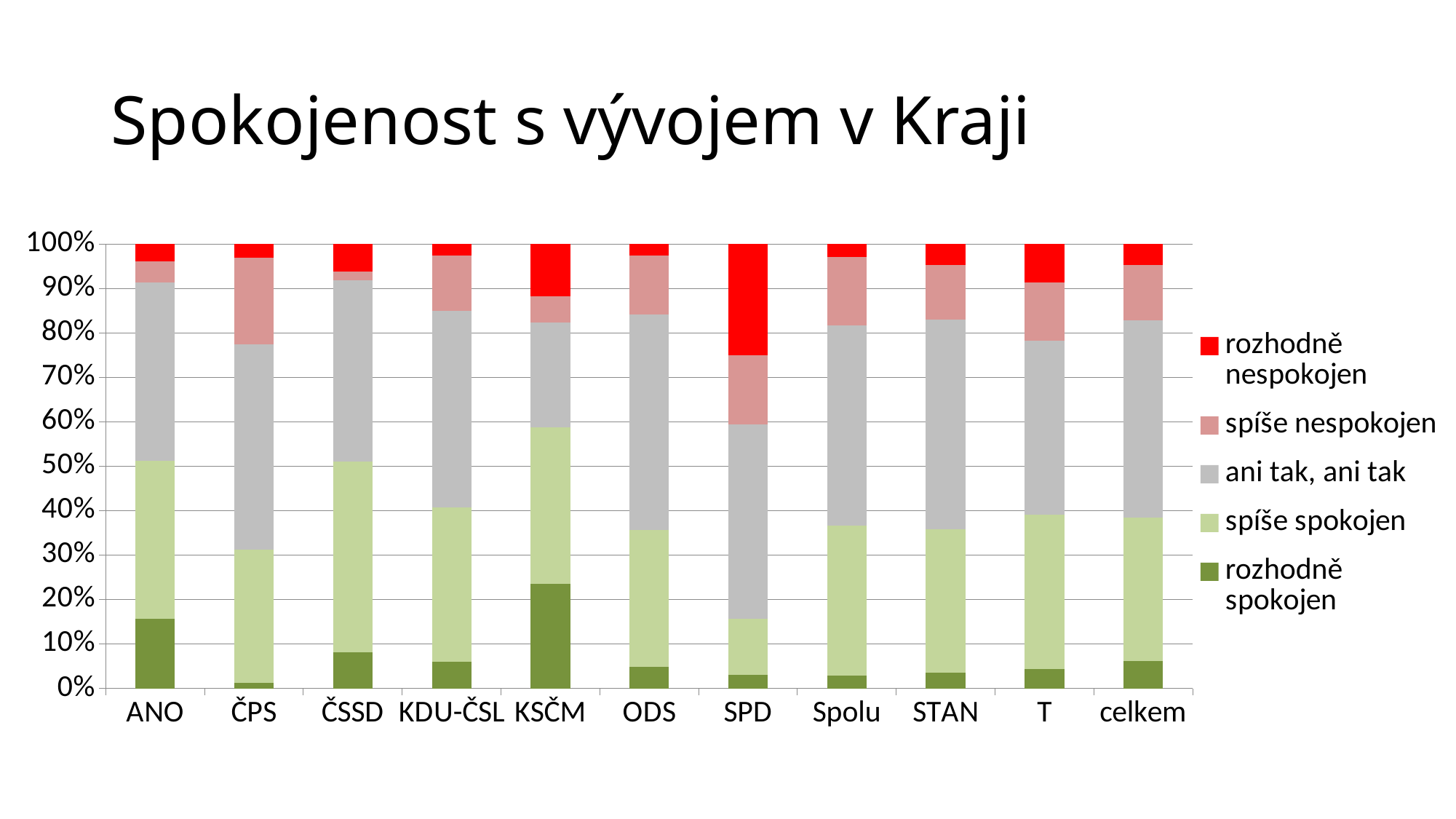
Which party has the largest 'rozhodně nespokojen' share? SPD Which party has the smallest 'rozhodně spokojen' share? ČPS Is the 'rozhodně spokojen' value for ČPS greater or less than 10%? less Which has a larger 'rozhodně spokojen' share, ANO or ČSSD? ANO What kind of chart is shown on the slide? stacked bar chart Is the 'rozhodně spokojen' value for KSČM greater or less than 20%? greater Which party has the largest 'rozhodně spokojen' share? KSČM How many series does the legend list? 5 How many categories (parties) are shown along the x axis? 11 What does each stacked bar total? 100% Which legend entry is shown in bright red? rozhodně nespokojen What is the title of the chart? Spokojenost s vývojem v Kraji